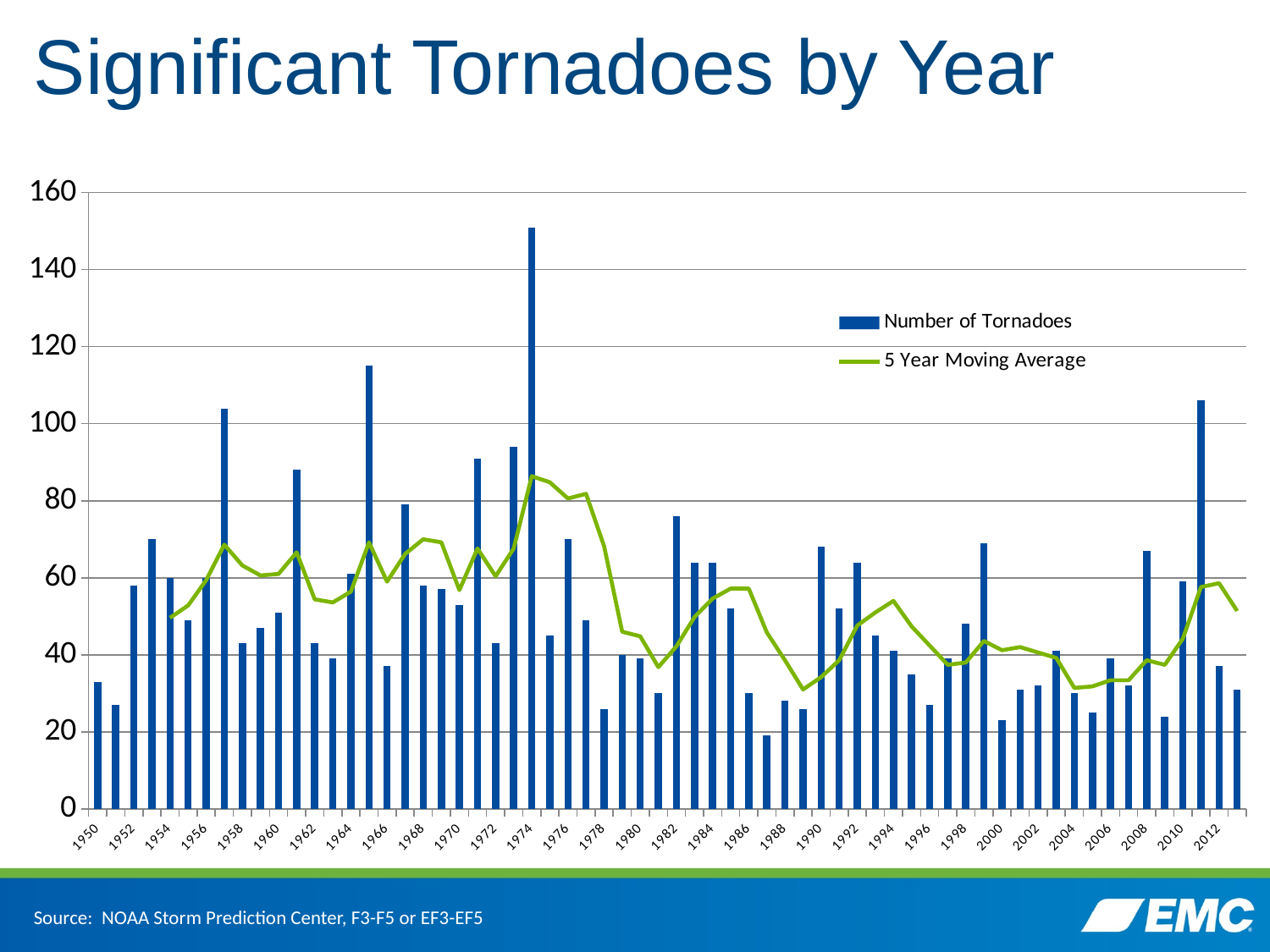
Which year has the highest number of tornadoes? 1974 Does the 5 Year Moving Average rise or fall between 1975 and 1981? fall Which year has the lowest number of tornadoes? 1987 What kind of chart is shown on the slide? combination bar and line chart Is the number of tornadoes for 1965 greater or less than 100? greater Is the number of tornadoes for 1974 greater or less than 140? greater Is the number of tornadoes for 1982 greater or less than 60? greater Which year had more tornadoes, 1990 or 1991? 1990 What colour is the 5 Year Moving Average line? green Which year had more tornadoes, 1974 or 1965? 1974 How many series does the legend list? 2